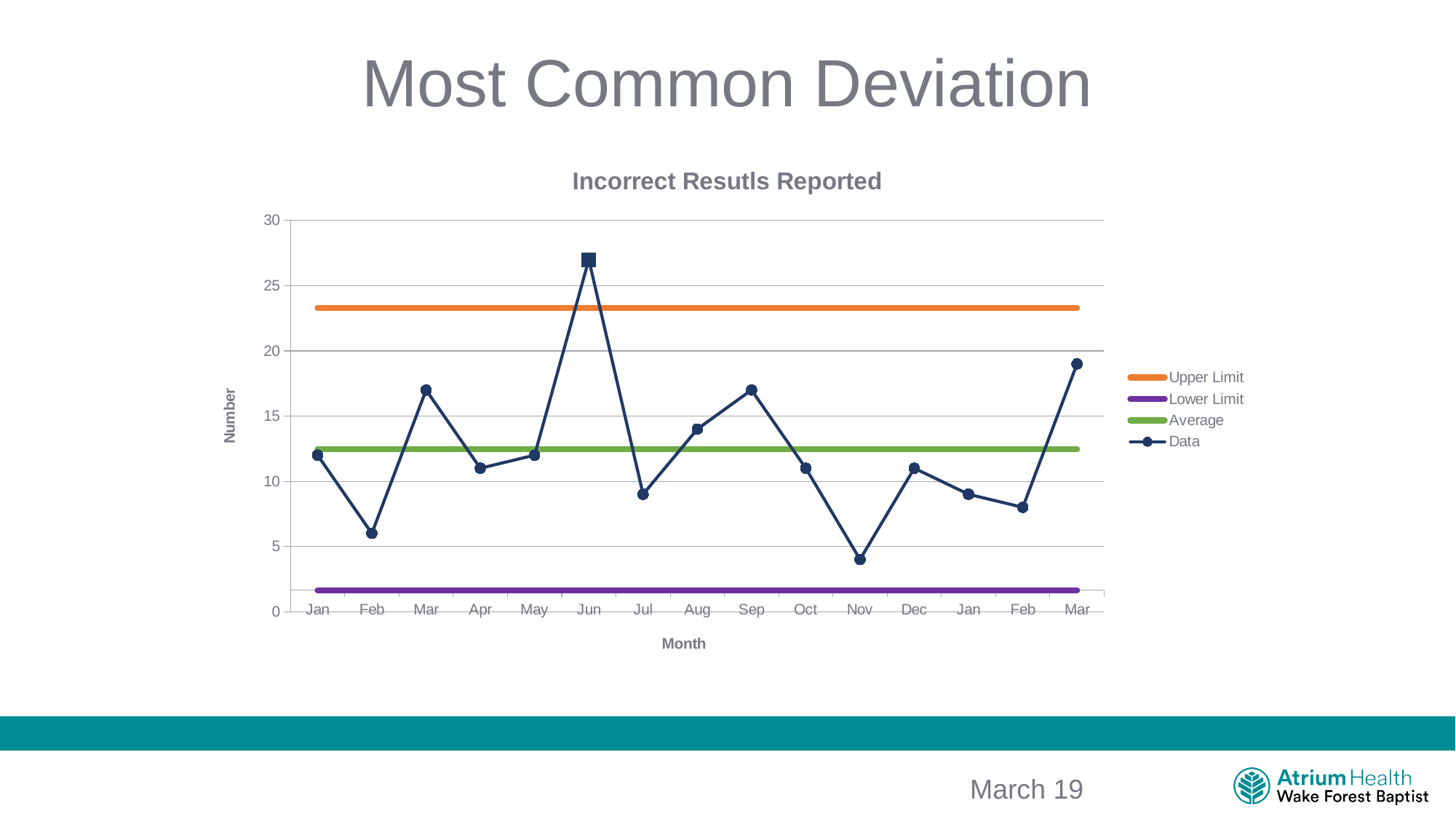
Is the Upper Limit line above or below 20 on the Number axis? above How many months are plotted along the x axis? 15 Is the Data value for the final Mar greater or less than 15? greater What kind of chart is shown on the slide? line chart What is the title of the chart? Incorrect Resutls Reported Is the Data value for Nov greater or less than 5? less In which month does the Data series reach its lowest value? Nov In which month does the Data series reach its highest value? Jun How many series does the legend list? 4 Which series is drawn in orange in the legend? Upper Limit Which month has the larger Data value, Sep or Oct? Sep